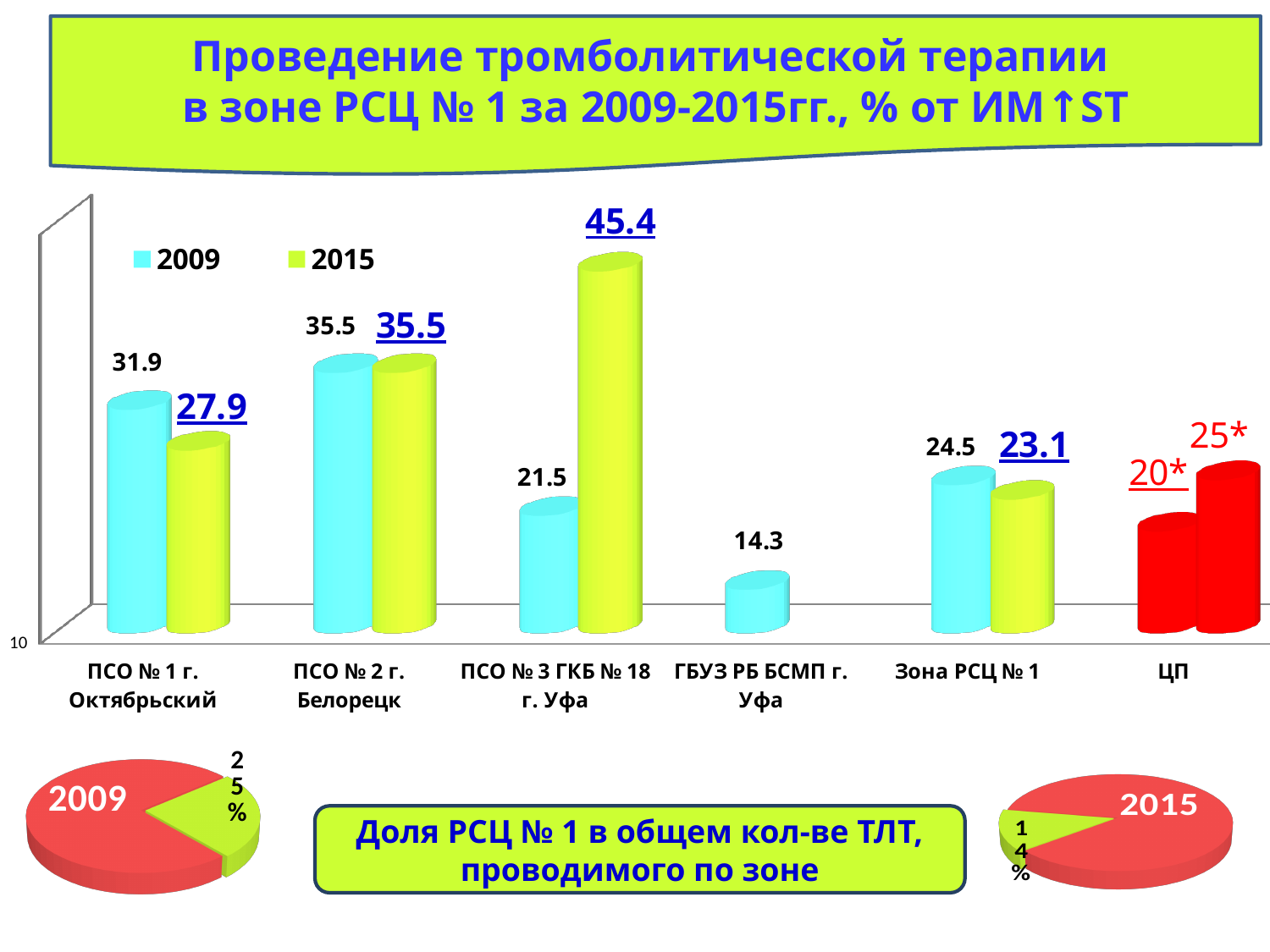
In the bar chart, which is larger for ПСО № 1 г. Октябрьский: the 2009 value or the 2015 value? 2009 In the bar chart, what is the difference between the 2015 and 2009 values for ПСО № 3 ГКБ № 18 г. Уфа? 23.9 In the bar chart, how many categories are shown on the x axis? 6 In the 2015 pie chart at the bottom right, what share is shown for the green slice? 14% In the bar chart, what is the 2015 value for ПСО № 3 ГКБ № 18 г. Уфа? 45.4 In the bar chart, which category has the lowest 2009 value? ГБУЗ РБ БСМП г. Уфа In the bar chart, what is the 2015 value for Зона РСЦ № 1? 23.1 In the 2009 pie chart at the bottom left, what share is shown for the green slice? 25% In the bar chart, which category has the highest 2015 value? ПСО № 3 ГКБ № 18 г. Уфа In the bar chart, what is the 2009 value for ГБУЗ РБ БСМП г. Уфа? 14.3 In the bar chart, what is the 2009 value for ПСО № 1 г. Октябрьский? 31.9 In the bar chart, how many series does the legend list? 2